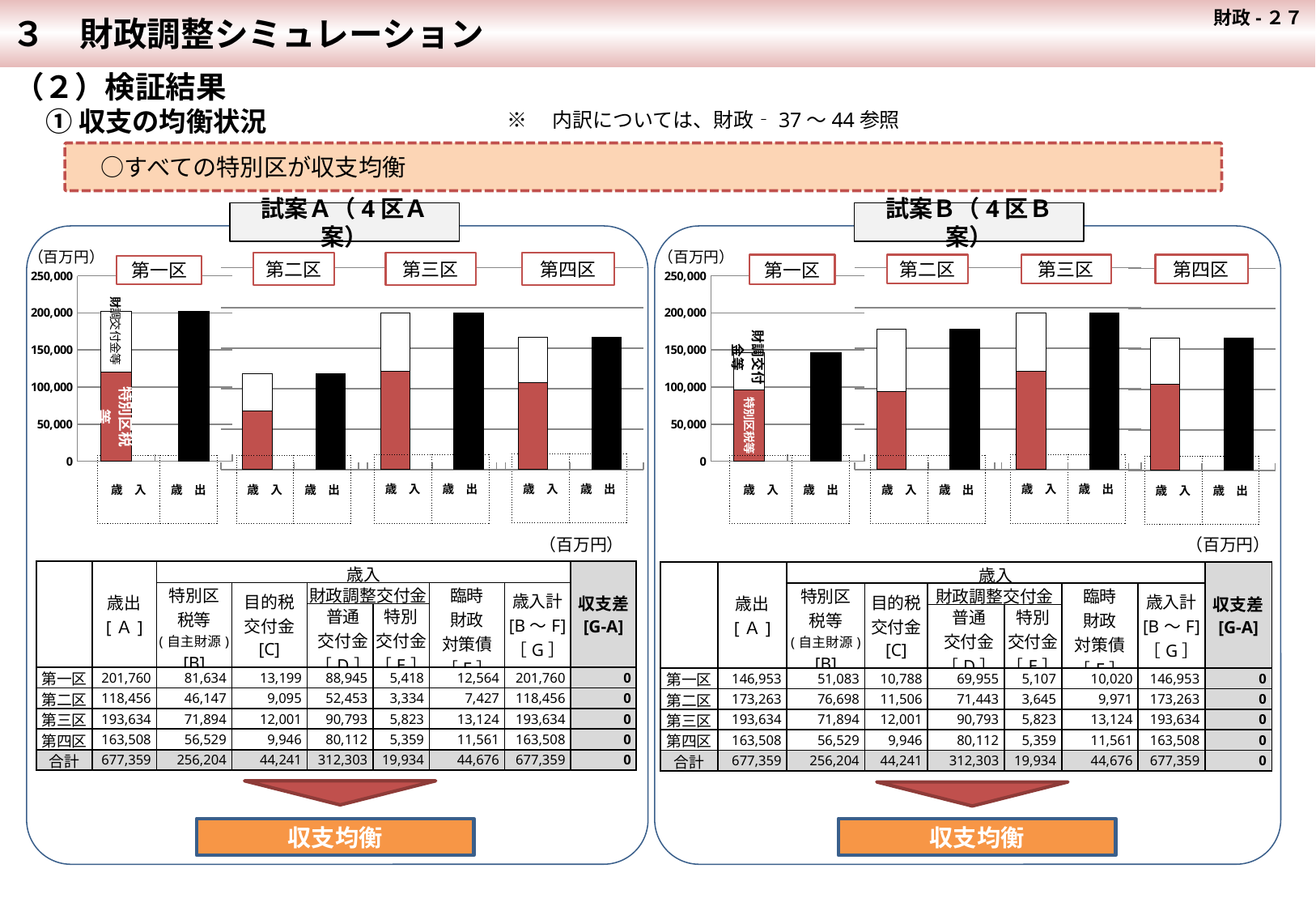
What kind of chart is the 試案A（4区A案） chart on the left? bar chart In the 試案B（4区B案） chart, is the 歳出 value for 第二区 greater or less than 150,000? greater In the 試案B（4区B案） chart, is the 特別区税等 (red) portion of the 歳入 bar for 第二区 greater or less than 50,000? greater What unit is shown on the vertical axis of the 試案B（4区B案） chart? 百万円 In the 試案A（4区A案） chart, how many 特別区 (wards) are shown? 4 In the 試案B（4区B案） chart, which ward has the lowest 歳出 bar? 第一区 In the 試案A（4区A案） chart, which ward has the lowest 歳出 bar? 第二区 In the 試案A（4区A案） chart, is the 歳出 value for 第四区 greater or less than 150,000? greater In the 試案B（4区B案） chart, which ward has the highest 歳出 bar? 第三区 In the 試案A（4区A案） chart, which is larger, the 歳出 for 第一区 or the 歳出 for 第二区? 第一区 In the 試案A（4区A案） chart, what colour is the 特別区税等 portion of the 歳入 bars? red